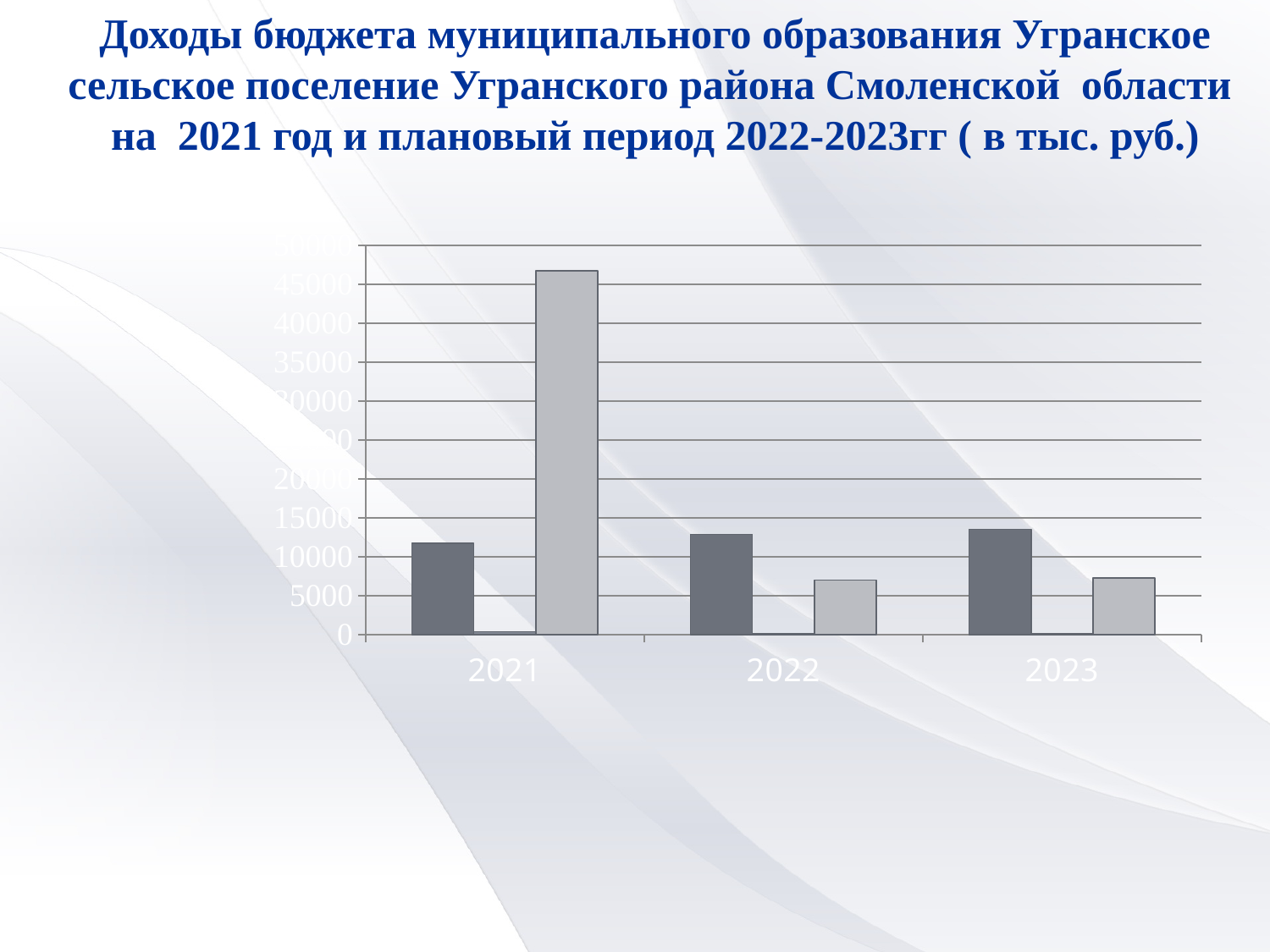
Is the value of the dark gray bar for 2021 greater or less than 15000? less In which year does the chart have its tallest bar? 2021 Which is larger: the light gray bar for 2021 or the light gray bar for 2022? 2021 Is the value of the dark gray bar for 2023 greater or less than 15000? less Is the value of the light gray bar for 2022 greater or less than 10000? less Which years are shown on the x axis of the chart? 2021, 2022, 2023 Do the light gray bars rise or fall from 2021 to 2022? fall How many years are shown on the x axis of the chart? 3 What is the highest value shown on the y axis of the chart? 50000 What kind of chart is shown on the slide? bar chart